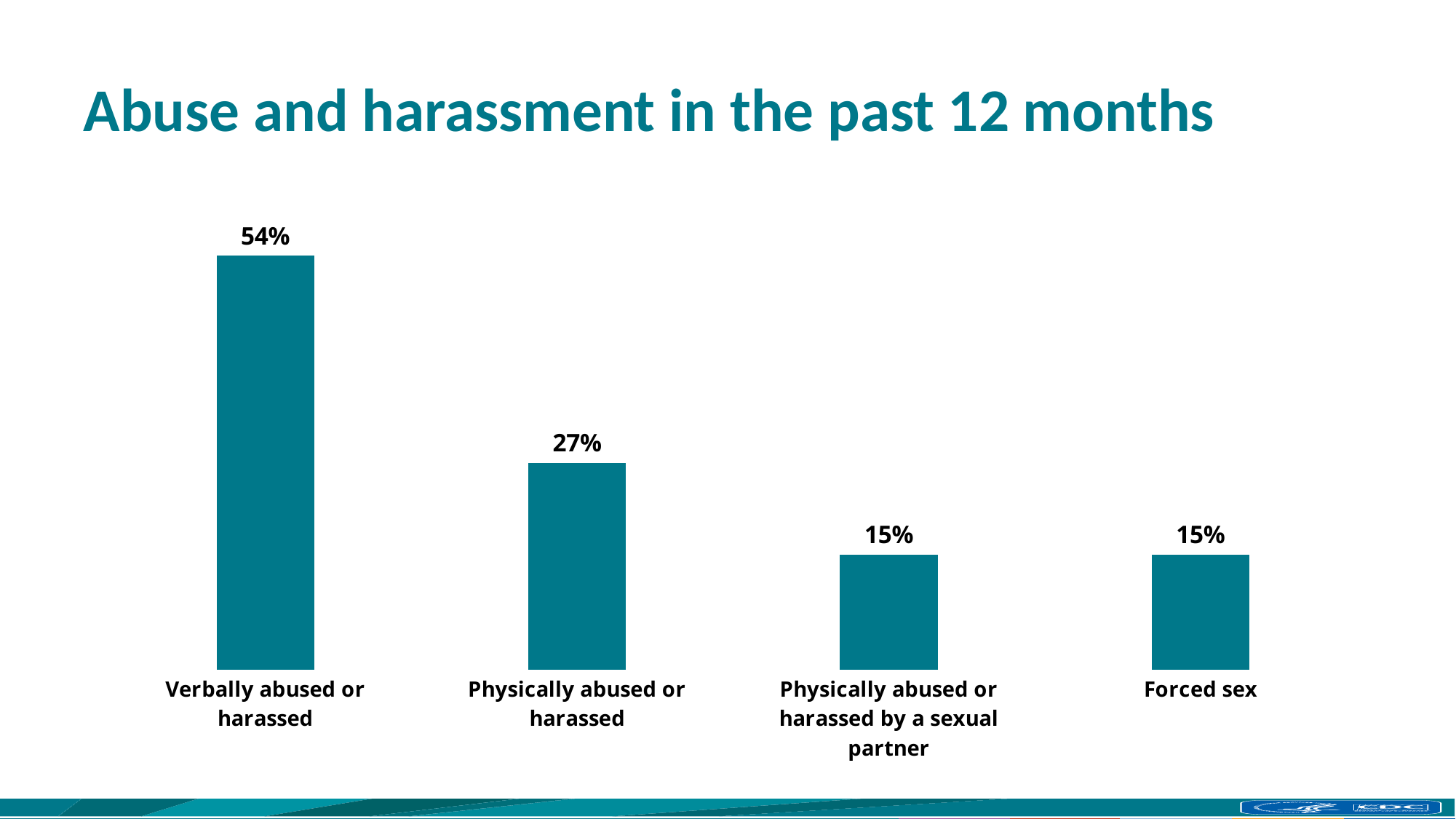
What is the difference between the values for verbally abused or harassed and physically abused or harassed? 27% Which category has the highest value? Verbally abused or harassed What is the title of the slide? Abuse and harassment in the past 12 months What percentage were physically abused or harassed? 27% What percentage were physically abused or harassed by a sexual partner? 15% What percentage reported forced sex? 15% How many categories are shown in the chart? 4 What is the difference between the values for physically abused or harassed and forced sex? 12% Do the values rise or fall from left to right across the categories? Fall What kind of chart is shown on the slide? Bar chart Which is larger: the value for verbally abused or harassed or the value for forced sex? Verbally abused or harassed What percentage were verbally abused or harassed? 54%